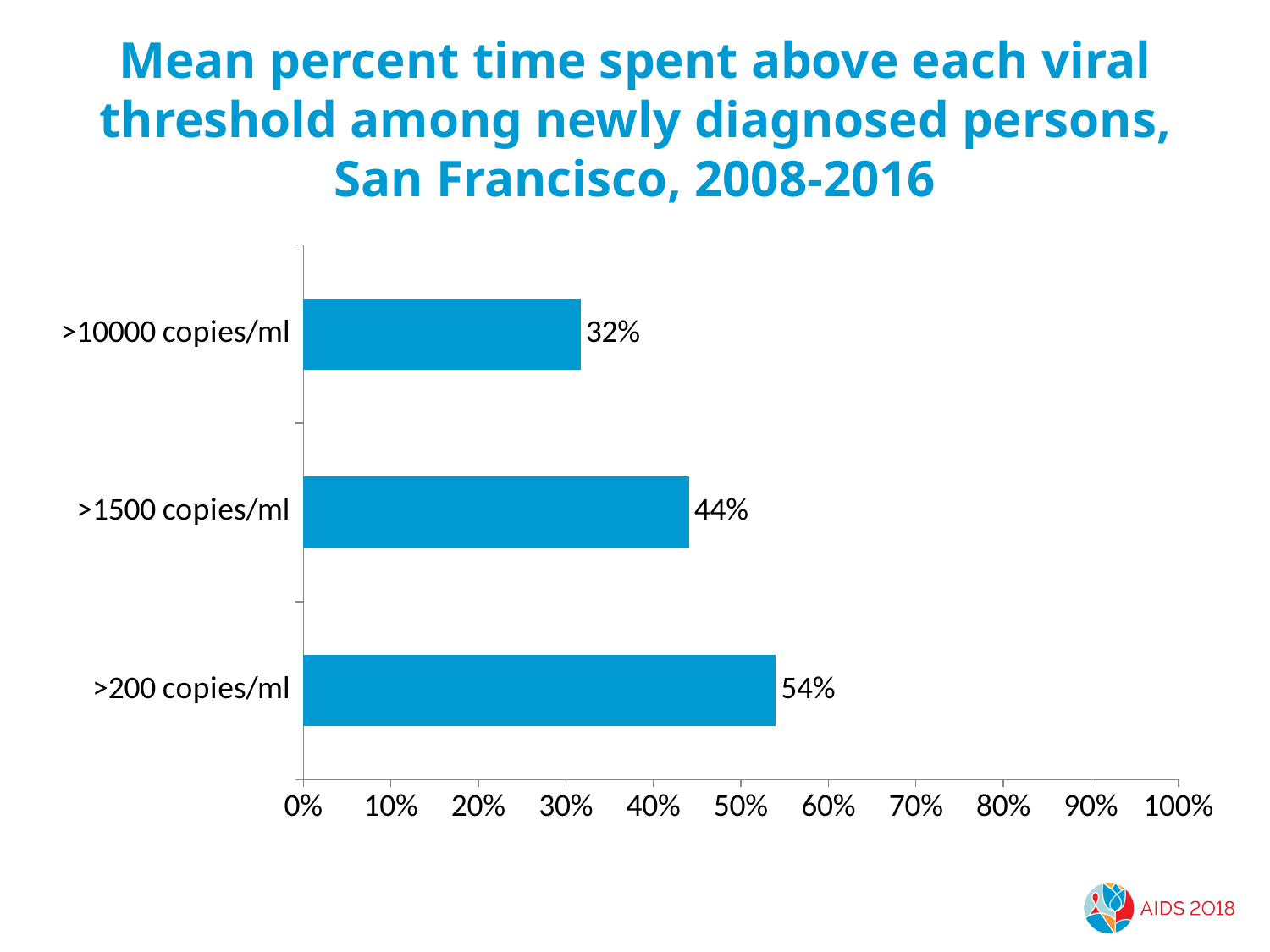
What is the mean percent time spent above >1500 copies/ml? 44% Is the value for >200 copies/ml greater or less than 50%? greater Which is larger, the value for >1500 copies/ml or the value for >10000 copies/ml? >1500 copies/ml What is the difference in mean percent time between >1500 copies/ml and >10000 copies/ml? 12% What is the mean percent time spent above >10000 copies/ml? 32% Which viral threshold has the highest mean percent time spent above it? >200 copies/ml How many viral threshold categories are shown in the chart? 3 What is the difference in mean percent time between >200 copies/ml and >10000 copies/ml? 22% What is the maximum value shown on the horizontal axis? 100% What kind of chart is shown on the slide? Bar chart Which viral threshold has the lowest mean percent time spent above it? >10000 copies/ml What is the mean percent time spent above >200 copies/ml? 54%